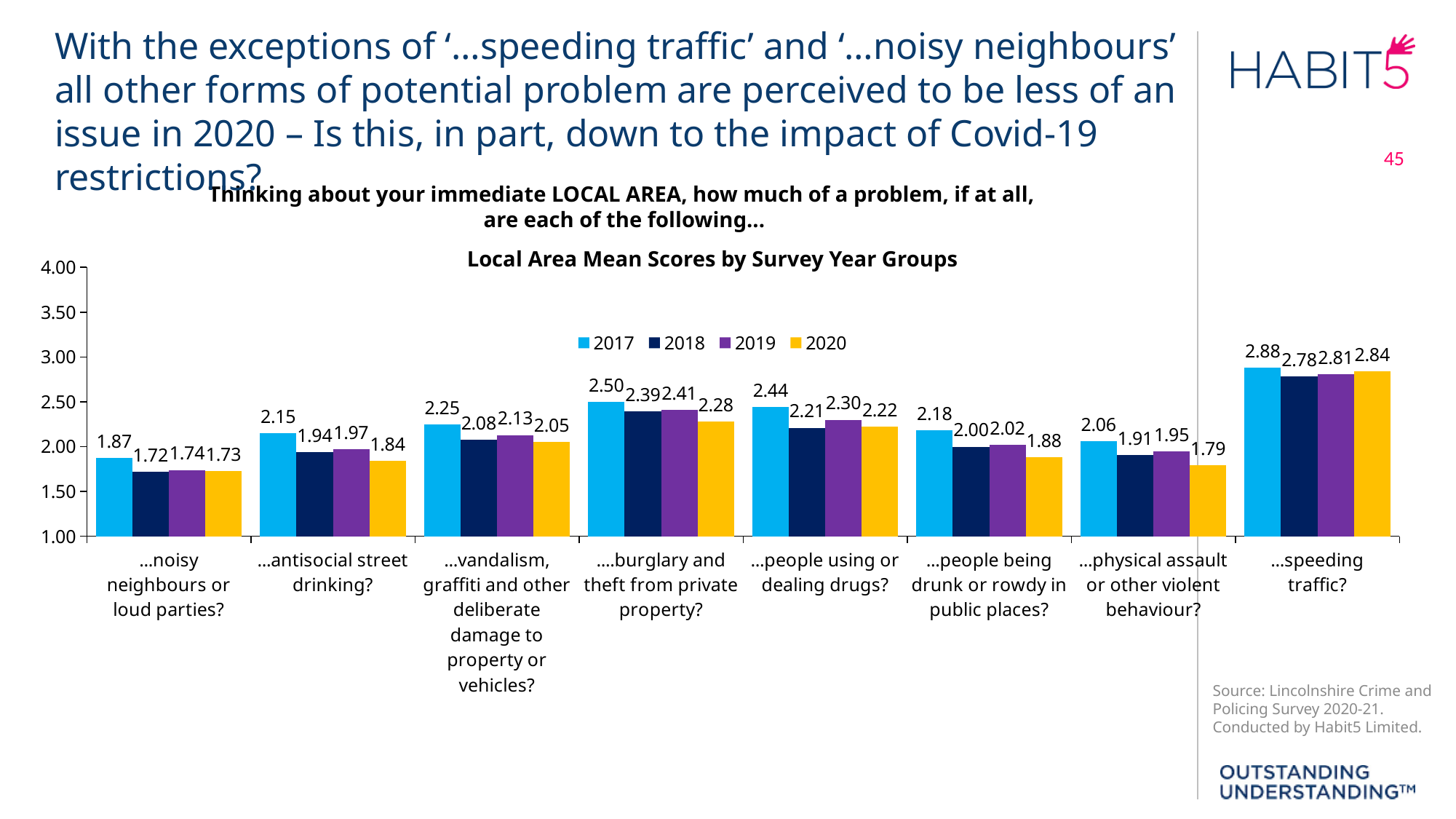
Which category has the lowest 2020 mean score? …noisy neighbours or loud parties? What is the 2020 mean score for '…speeding traffic?'? 2.84 What kind of chart is shown on the slide? Bar chart Which category has the highest 2020 mean score? …speeding traffic? What is the title of the chart? Local Area Mean Scores by Survey Year Groups What is the difference between the 2017 and 2020 mean scores for '…physical assault or other violent behaviour?'? 0.27 Which is larger for '…noisy neighbours or loud parties?': the 2019 score or the 2020 score? 2019 How many categories are shown on the x axis? 8 What is the 2018 mean score for '…antisocial street drinking?'? 1.94 How many series does the legend list? 4 What is the 2017 mean score for '….burglary and theft from private property?'? 2.50 What is the 2019 mean score for '…people using or dealing drugs?'? 2.30